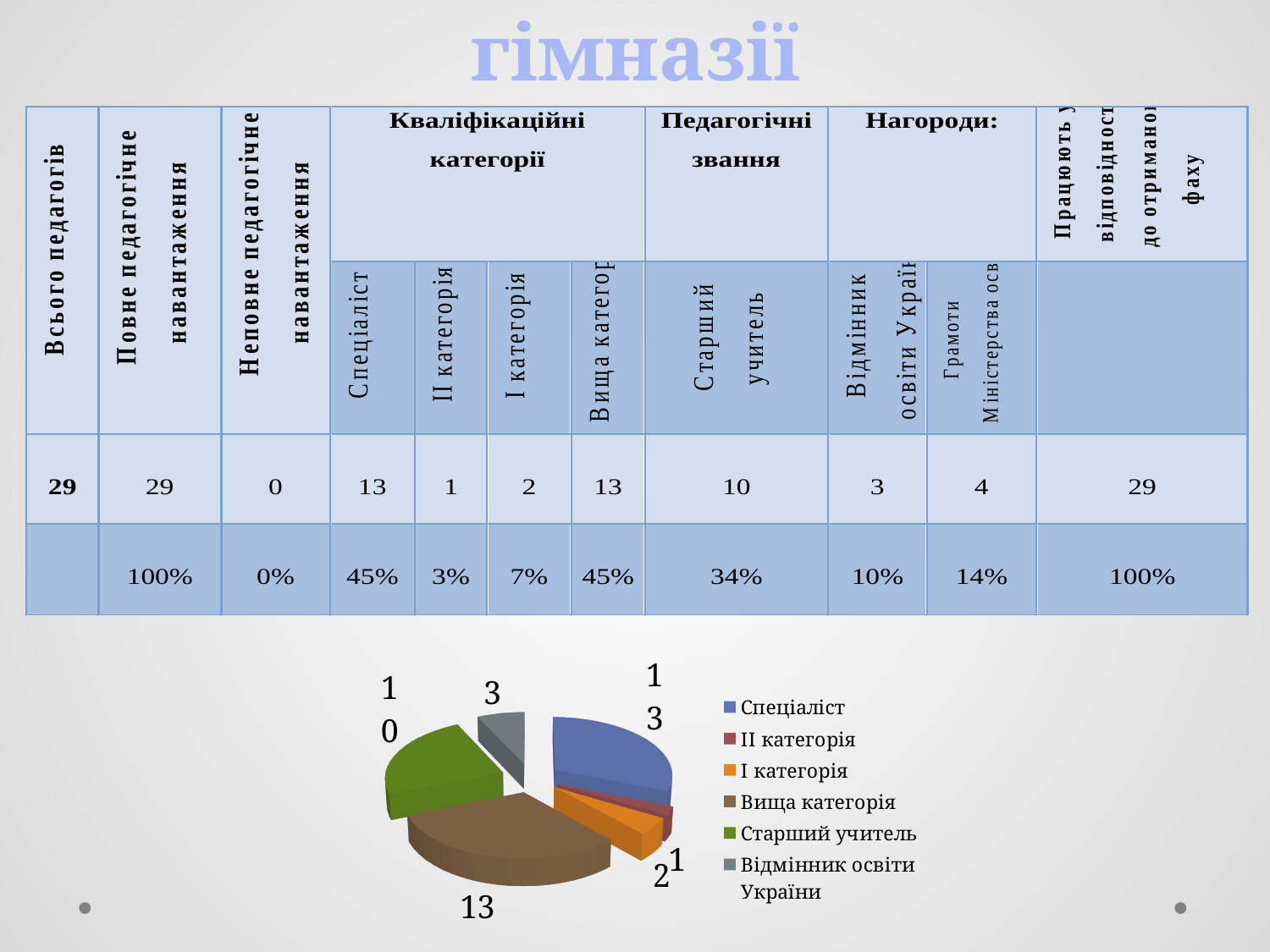
In the pie chart, what is the difference between the Старший учитель value and the Відмінник освіти України value? 7 In the pie chart, which is larger: Старший учитель or Відмінник освіти України? Старший учитель In the pie chart, what is the difference between the Вища категорія value and the Старший учитель value? 3 Which slice of the pie chart has the smallest value? ІІ категорія What is the value of the І категорія slice in the pie chart? 2 What is the value of the Старший учитель slice in the pie chart? 10 How many slices does the pie chart have? 6 How many entries does the legend of the pie chart list? 6 Which colour represents Вища категорія in the pie chart legend? brown What kind of chart is shown at the bottom of the slide? pie chart What is the value of the Відмінник освіти України slice in the pie chart? 3 What is the value of the Спеціаліст slice in the pie chart? 13